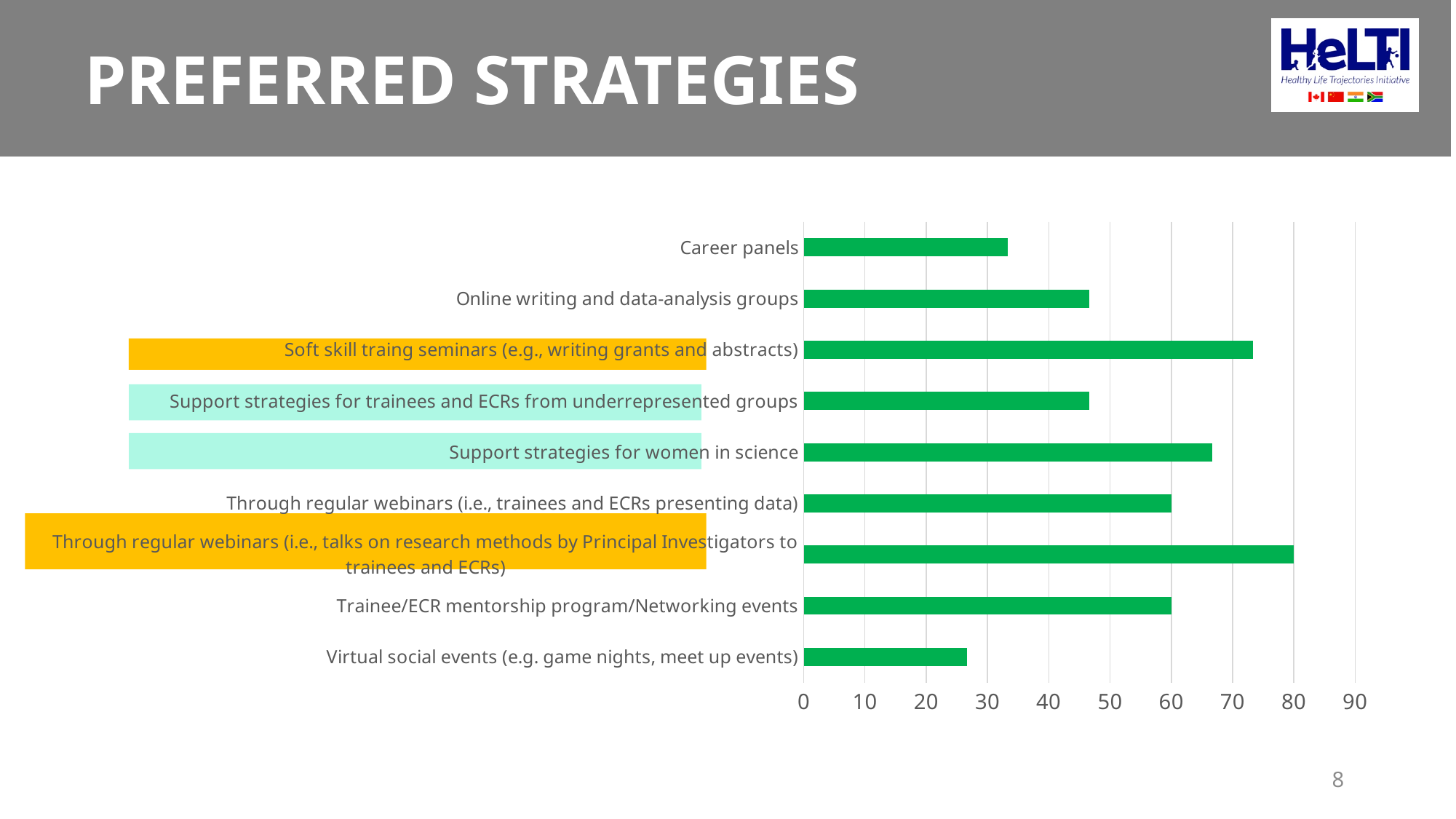
Is the value for Career panels greater or less than 40? less How many strategies (categories) are plotted in the chart? 9 Is the value for Support strategies for trainees and ECRs from underrepresented groups greater or less than 50? less What kind of chart is shown on the slide? bar chart Which has a larger value: Support strategies for women in science or Online writing and data-analysis groups? Support strategies for women in science What is the title of the slide containing the chart? PREFERRED STRATEGIES Is the value for Online writing and data-analysis groups greater or less than 40? greater Which has a larger value: Soft skill traing seminars or Career panels? Soft skill traing seminars Which strategy has the lowest value in the chart? Virtual social events (e.g. game nights, meet up events) Which strategy has the highest value in the chart? Through regular webinars (i.e., talks on research methods by Principal Investigators to trainees and ECRs)